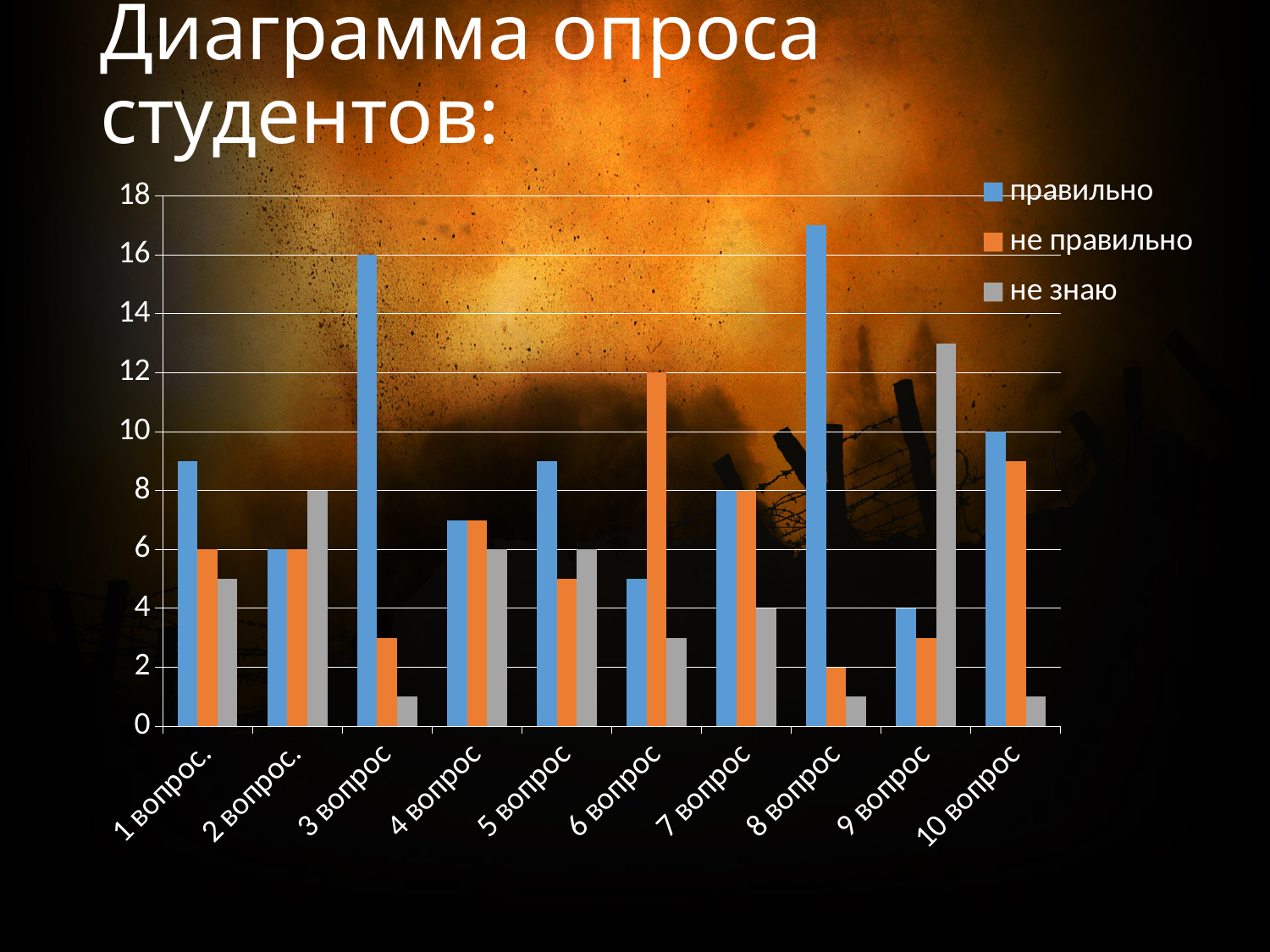
What is the value of 'не знаю' for 2 вопрос? 8 What is the difference between 'правильно' for 3 вопрос and 'не правильно' for 6 вопрос? 4 Which is larger: 'правильно' for 8 вопрос or 'не знаю' for 9 вопрос? правильно for 8 вопрос What is the value of 'правильно' for 10 вопрос? 10 For which question is the 'правильно' value highest? 8 вопрос How many series does the legend list? 3 What is the value of 'не правильно' for 6 вопрос? 12 What type of chart is shown on the slide? bar chart For which question is the 'не знаю' value highest? 9 вопрос Is the 'правильно' value for 8 вопрос greater or less than 16? greater What is the value of 'правильно' for 3 вопрос? 16 How many question categories are shown on the x axis? 10